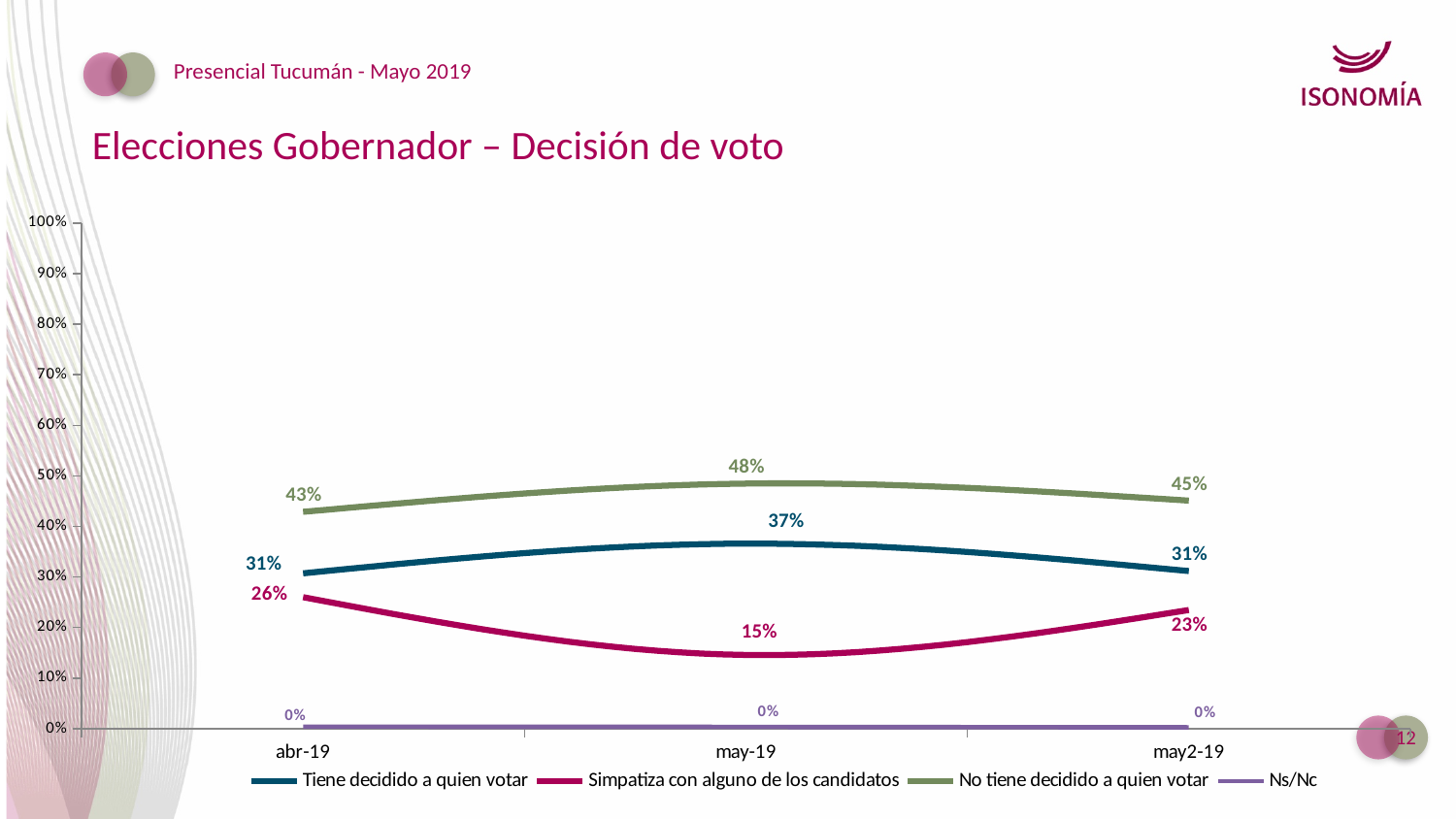
How many dates are shown on the x axis? 3 Does 'Simpatiza con alguno de los candidatos' rise or fall from may-19 to may2-19? Rise At which date is 'Tiene decidido a quien votar' highest? may-19 What is the value for 'Simpatiza con alguno de los candidatos' at abr-19? 26% What is the value for 'Tiene decidido a quien votar' at may2-19? 31% What is the difference between 'No tiene decidido a quien votar' and 'Tiene decidido a quien votar' at may-19? 11% How many series does the legend list? 4 What is the value for 'No tiene decidido a quien votar' at may-19? 48% Which is larger at abr-19: 'Tiene decidido a quien votar' or 'Simpatiza con alguno de los candidatos'? Tiene decidido a quien votar What kind of chart is this? Line chart At which date is 'Simpatiza con alguno de los candidatos' lowest? may-19 What is the value for Ns/Nc at may2-19? 0%